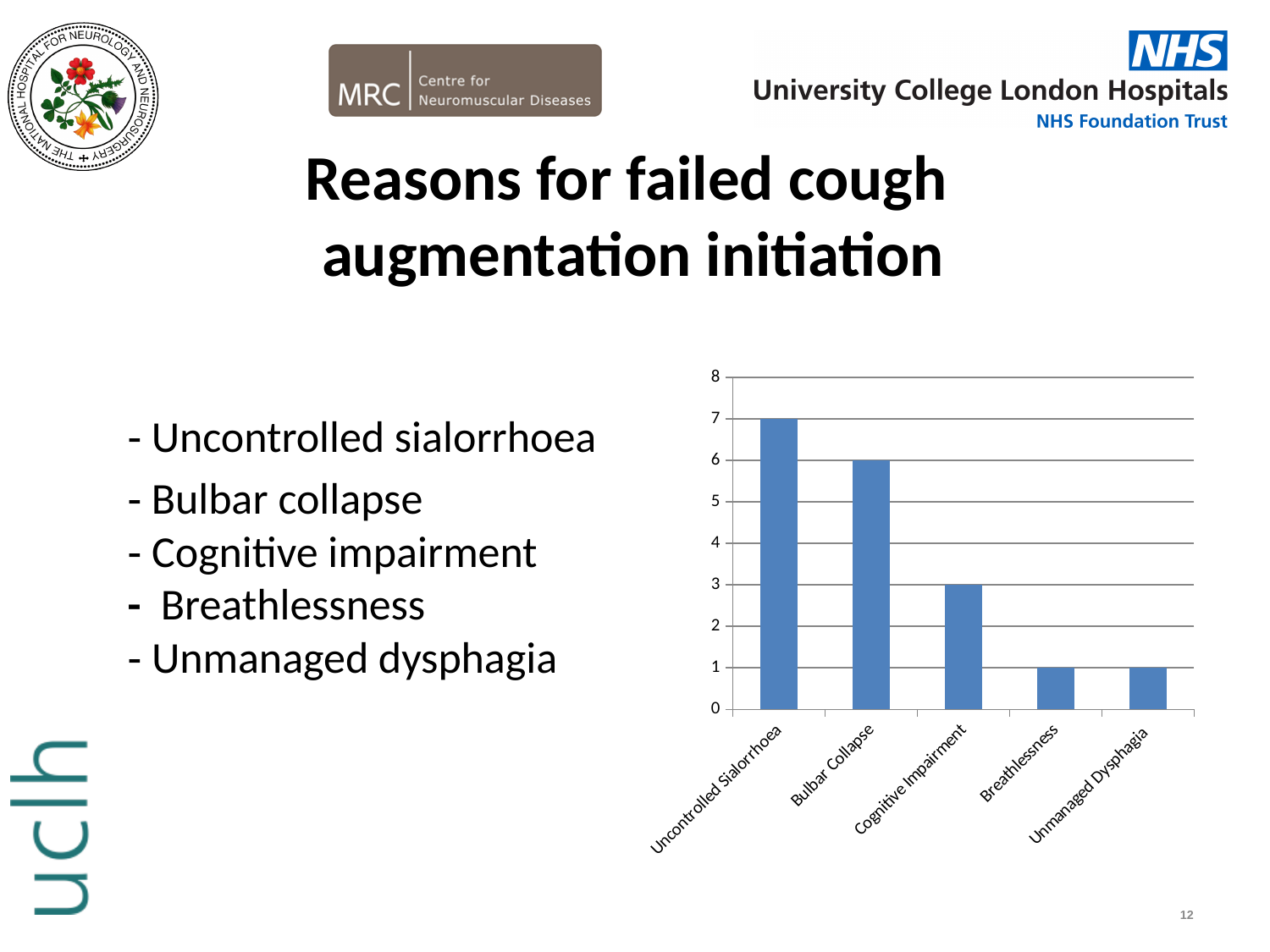
Which is larger, the value for Bulbar Collapse or the value for Cognitive Impairment? Bulbar Collapse Do the values rise or fall moving from left to right along the x axis? fall What is the value for Cognitive Impairment? 3 What is the highest value shown on the y axis of the chart? 8 What is the difference between the values for Uncontrolled Sialorrhoea and Cognitive Impairment? 4 How many categories are shown on the x axis of the chart? 5 What is the value for Uncontrolled Sialorrhoea? 7 What is the value for Bulbar Collapse? 6 Is the value for Uncontrolled Sialorrhoea greater or less than 5? greater What is the value for Breathlessness? 1 Which category has the highest value? Uncontrolled Sialorrhoea What type of chart is shown on the slide? bar chart